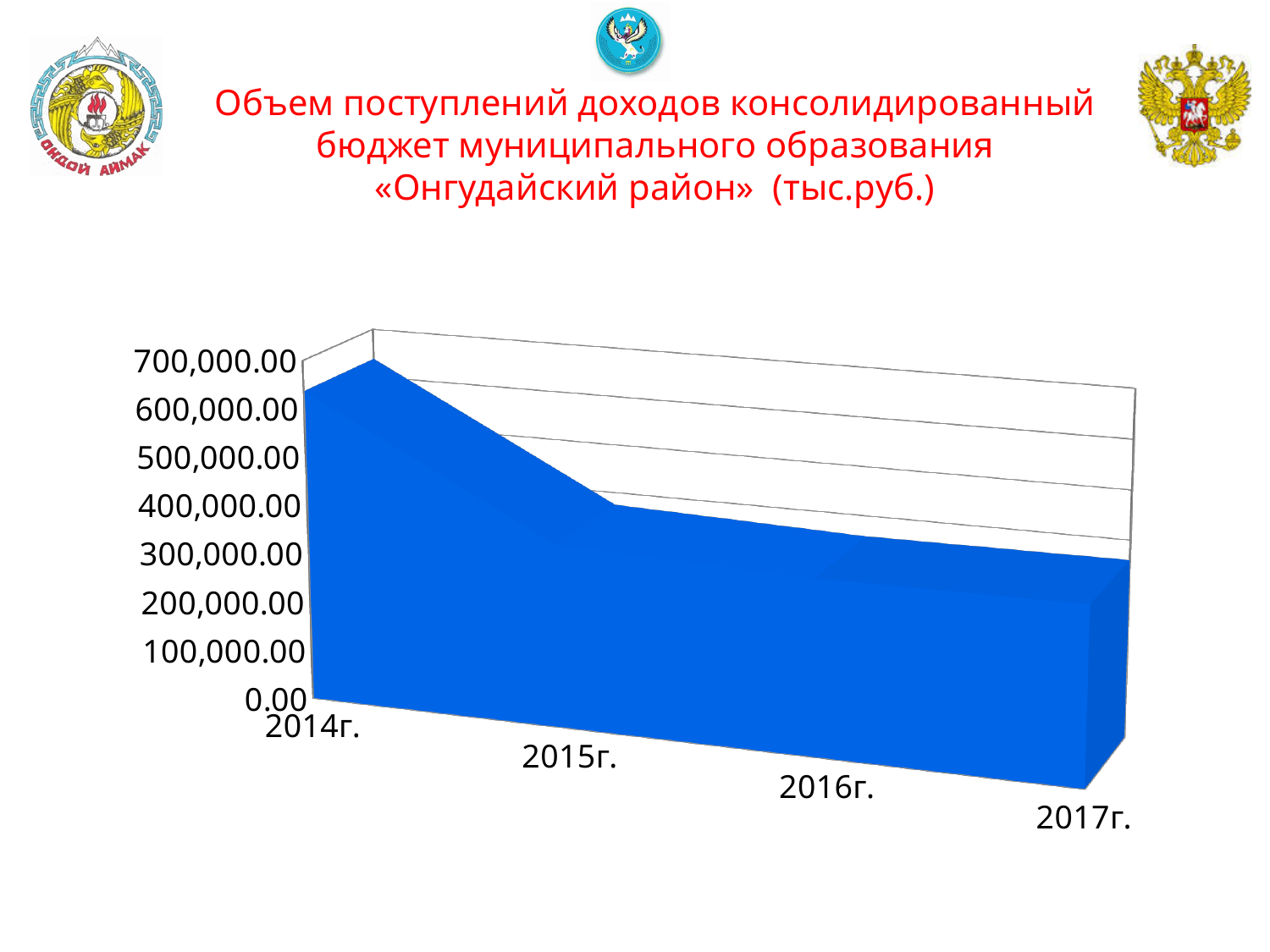
Is the value for 2014г. greater or less than 500,000.00? greater Is the value for 2017г. greater or less than 200,000.00? greater Which is larger, the value for 2014г. or the value for 2015г.? 2014г. Is the value for 2016г. greater or less than 500,000.00? less Do the values rise or fall from 2014г. to 2017г.? fall What kind of chart is shown on the slide? area chart Which is larger, the value for 2015г. or the value for 2017г.? 2015г. In what units are the values in the chart expressed, according to the slide title? тыс.руб. Which year has the highest value in the chart? 2014г. How many years are plotted on the x axis of the chart? 4